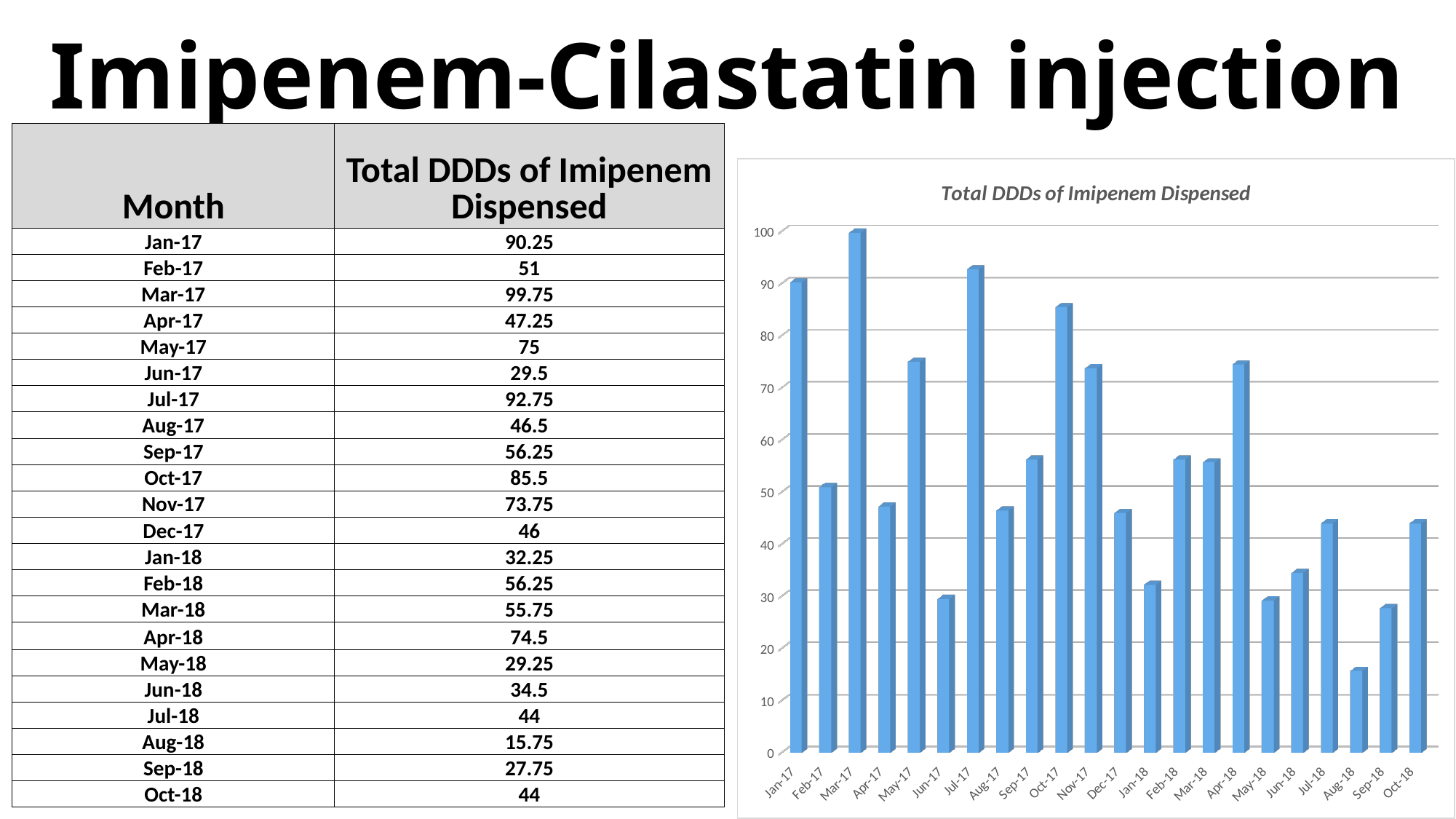
Which month has the highest total DDDs of Imipenem dispensed? Mar-17 Which month had more DDDs dispensed, Oct-17 or Apr-18? Oct-17 What is the total DDDs of Imipenem dispensed in Jul-17? 92.75 What is the title of the chart? Total DDDs of Imipenem Dispensed What is the total DDDs of Imipenem dispensed in Oct-18? 44 Is the value for Jun-17 greater or less than 40? less Is the value for Nov-17 greater or less than 60? greater What type of chart is shown on the slide? bar chart What is the difference between the total DDDs dispensed in Jan-17 and Feb-17? 39.25 Which month has the lowest total DDDs of Imipenem dispensed? Aug-18 What is the difference between the total DDDs dispensed in Mar-17 and Aug-18? 84 How many months are plotted in the chart? 22